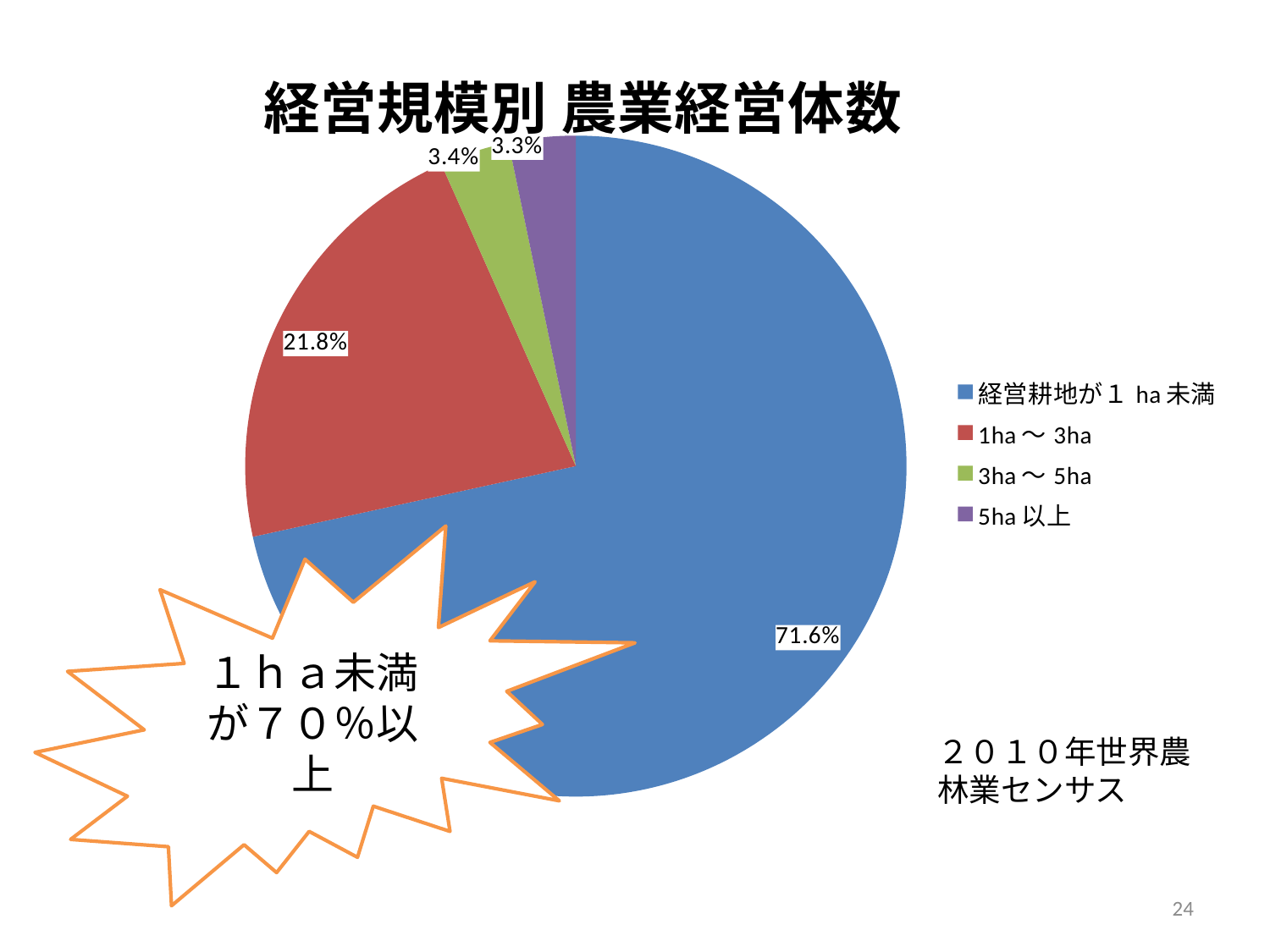
What share of the pie is 1ha～3ha? 21.8% What share of the pie is 5ha以上? 3.3% Which is larger, the share of 1ha～3ha or the share of 3ha～5ha? 1ha～3ha How many categories does the pie chart have? 4 What is the difference between the shares of 経営耕地が1ha未満 and 1ha～3ha? 49.8% Which category has the largest slice of the pie? 経営耕地が1ha未満 What share of the pie is 経営耕地が1ha未満? 71.6% What kind of chart is shown on the slide? pie chart Which category has the smallest slice of the pie? 5ha以上 What is the title of the chart? 経営規模別 農業経営体数 What colour is the slice for 1ha～3ha? red